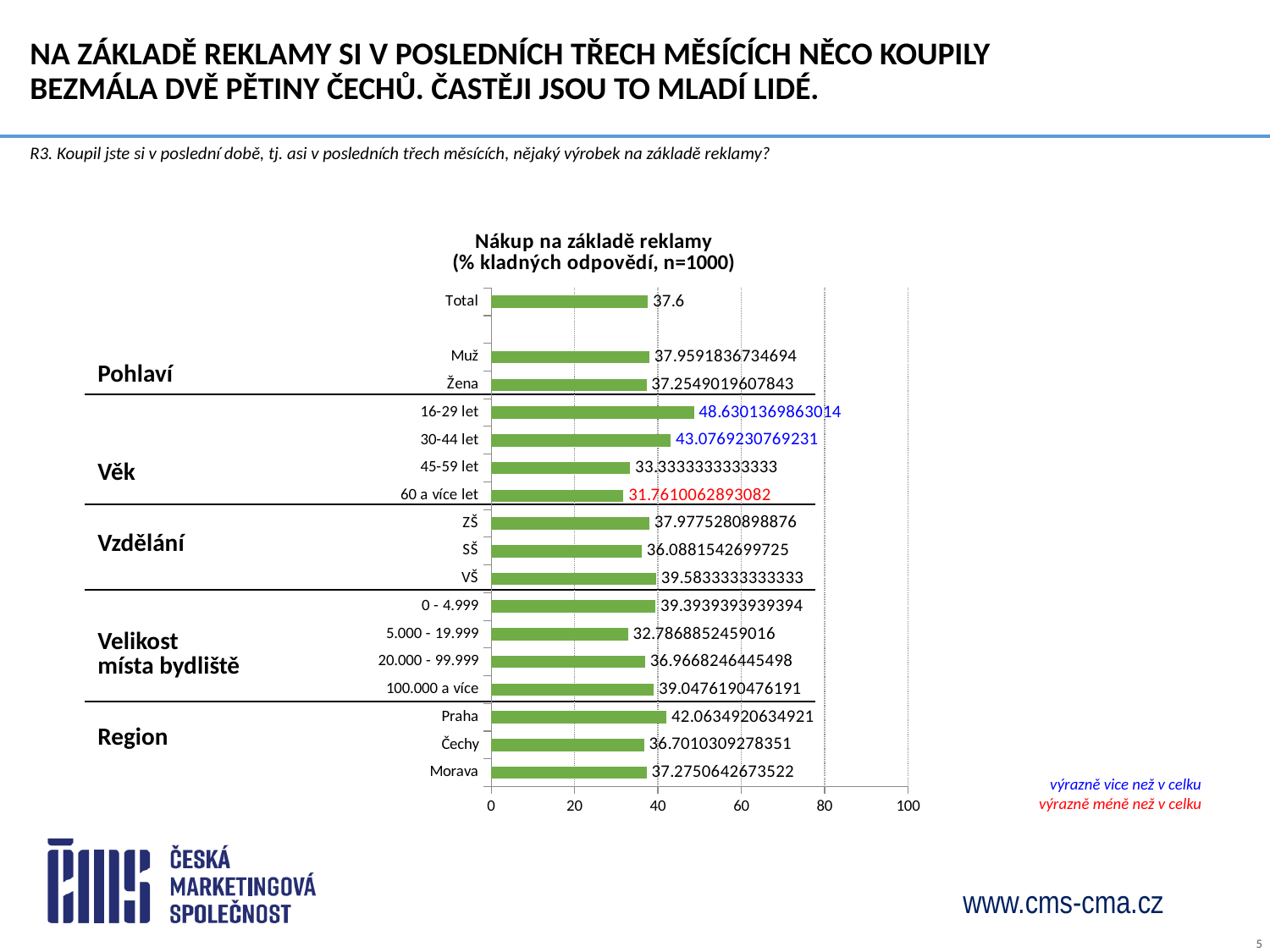
What is the value for 5.000 - 19.999? 32.7868852459016 Is the value for 45-59 let greater or less than 40? less What is the value for Total in the chart? 37.6 Which category has the highest value in the chart? 16-29 let Which has a larger value, 30-44 let or 45-59 let? 30-44 let What is the value for 16-29 let? 48.6301369863014 Which has a larger value, Muž or Žena? Muž How many bars (categories) are plotted in the chart? 17 What is the value for Praha? 42.0634920634921 What is the title of the chart? Nákup na základě reklamy (% kladných odpovědí, n=1000) Which category has the lowest value in the chart? 60 a více let What type of chart is shown on the slide? bar chart